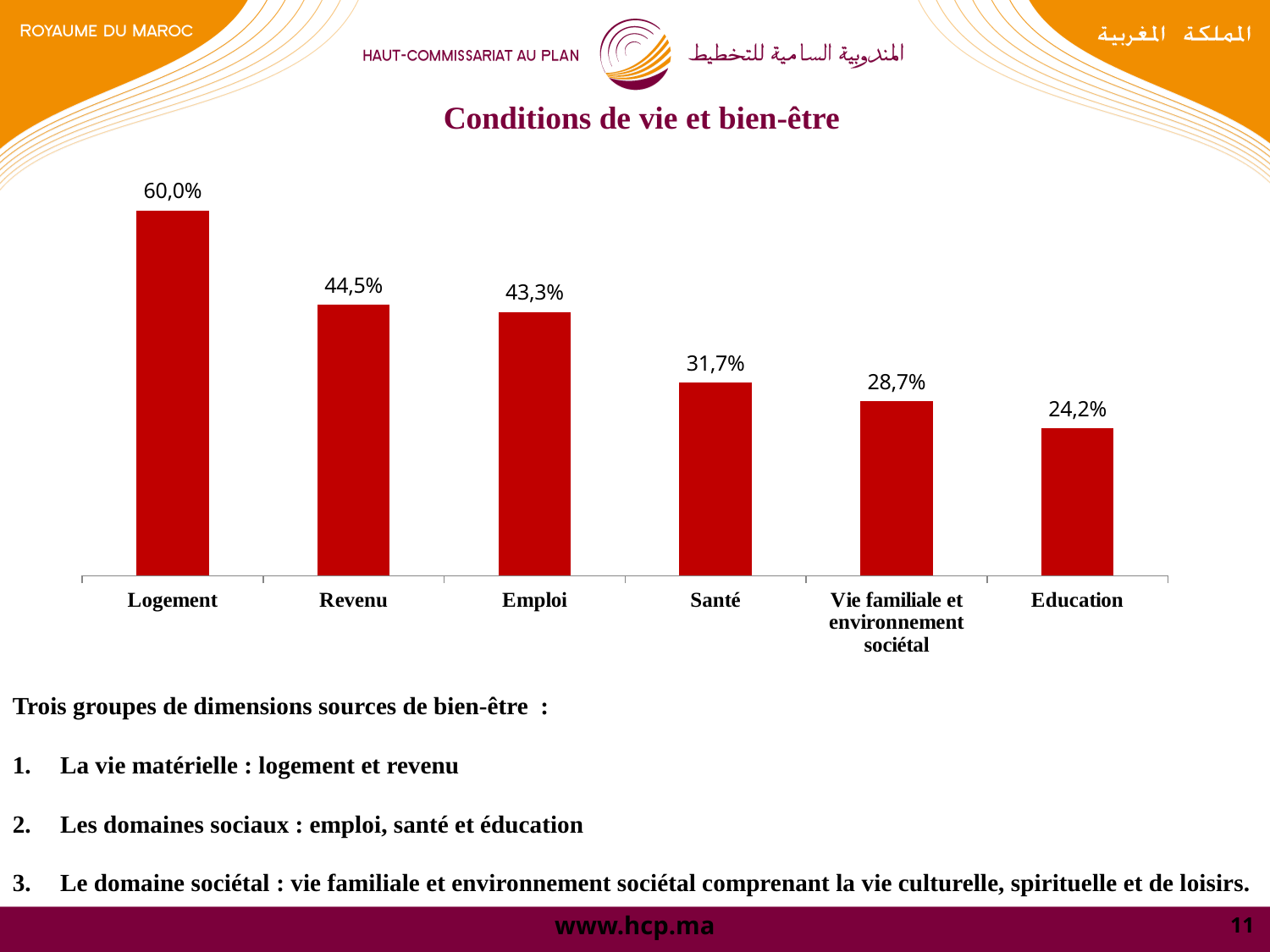
What is the value for Logement? 60,0% What is the value for Vie familiale et environnement sociétal? 28,7% What is the difference between the values for Logement and Revenu? 15,5% What is the title of the chart? Conditions de vie et bien-être What is the difference between the values for Santé and Education? 7,5% Which is larger, the value for Revenu or the value for Emploi? Revenu What kind of chart is shown on the slide? Bar chart Do the values rise or fall from left to right along the x axis? Fall How many categories are shown in the chart? 6 Which category has the highest value? Logement Which category has the lowest value? Education What is the value for Santé? 31,7%